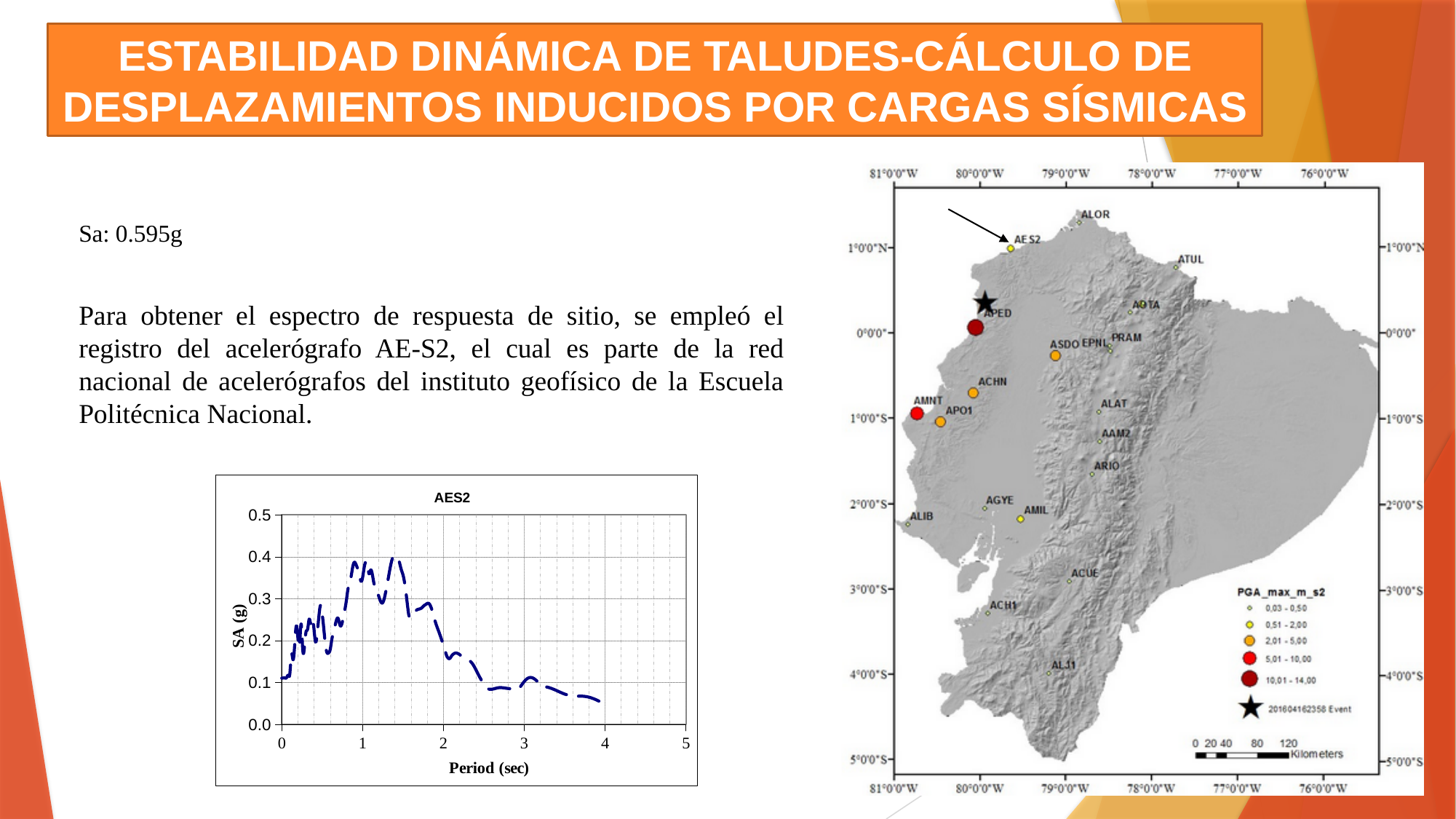
In the AES2 chart, is the value at a period of 3 sec greater or less than 0.2? less In the AES2 chart, is the value at a period of 0 sec greater or less than 0.2? less In the AES2 chart, is the value at a period of 4 sec greater or less than 0.1? less What is the highest tick value shown on the y axis of the AES2 chart? 0.5 In the AES2 chart, is the value at a period of 1 sec larger or smaller than the value at a period of 3 sec? larger In the AES2 chart, do the values rise or fall as the period increases from 2 sec to 4 sec? fall What is the title of the chart in the lower left of the slide? AES2 What is the label of the x axis of the AES2 chart? Period (sec) What kind of chart is the AES2 chart on the slide? line chart